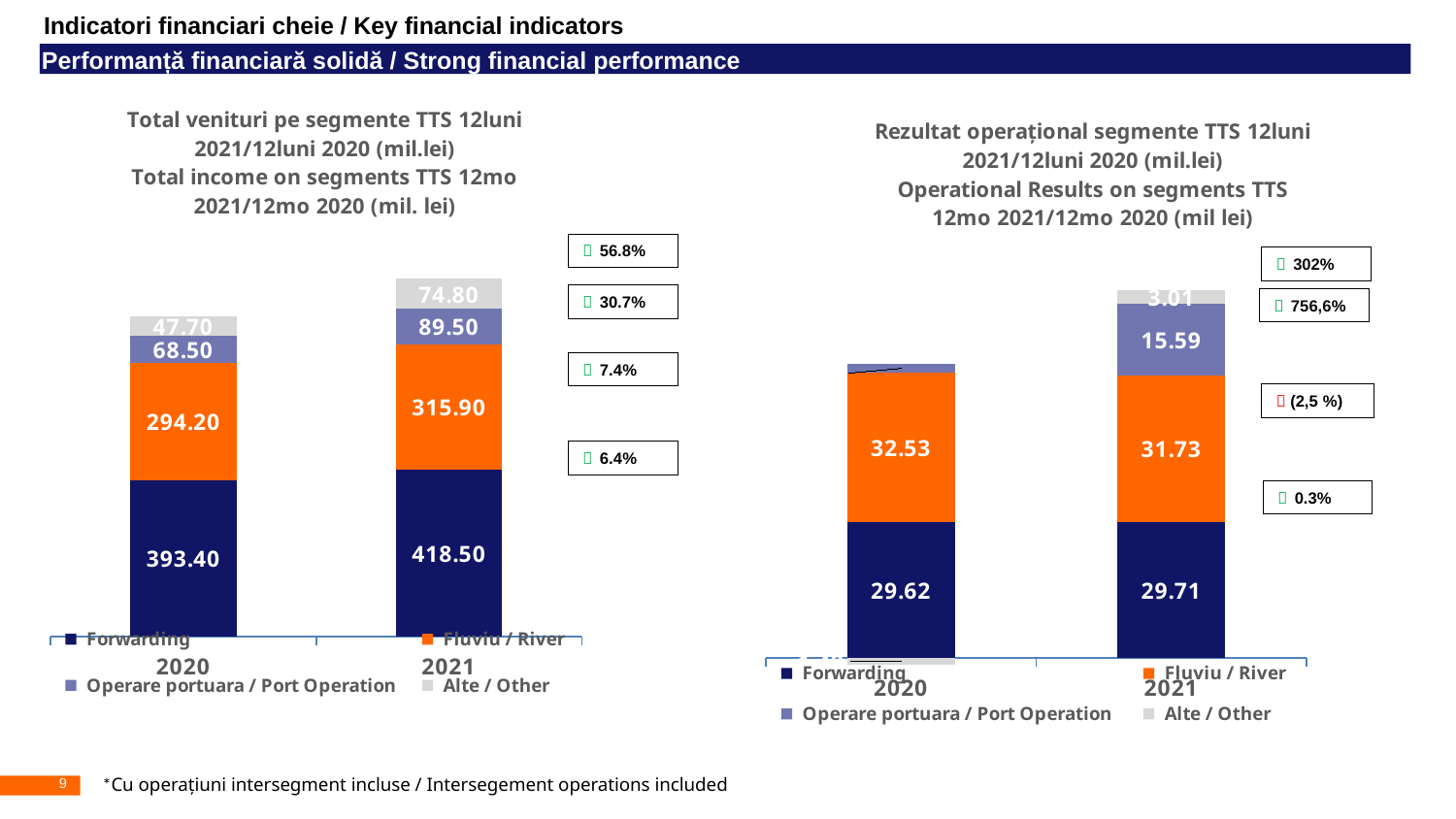
On the Total income on segments chart, what is the total of the stacked bar for 2020? 803.80 On the Total income on segments chart, what is the total of the stacked bar for 2021? 898.70 On the Operational Results on segments chart, what is the value for Operare portuara / Port Operation in 2021? 15.59 On the Operational Results on segments chart, which is larger in 2021: Forwarding or Fluviu / River? Fluviu / River On the Total income on segments chart, what is the value for Forwarding in 2021? 418.50 On the Total income on segments chart, what is the value for Fluviu / River in 2020? 294.20 On the Total income on segments chart, which segment has the highest value in 2021? Forwarding On the Total income on segments chart, what is the value for Alte / Other in 2021? 74.80 On the Operational Results on segments chart, what is the value for Fluviu / River in 2020? 32.53 How many series does the legend of the Operational Results on segments chart list? 4 What kind of chart is the Total income on segments chart? Stacked bar chart On the Total income on segments chart, what is the difference between the Operare portuara / Port Operation values for 2021 and 2020? 21.00